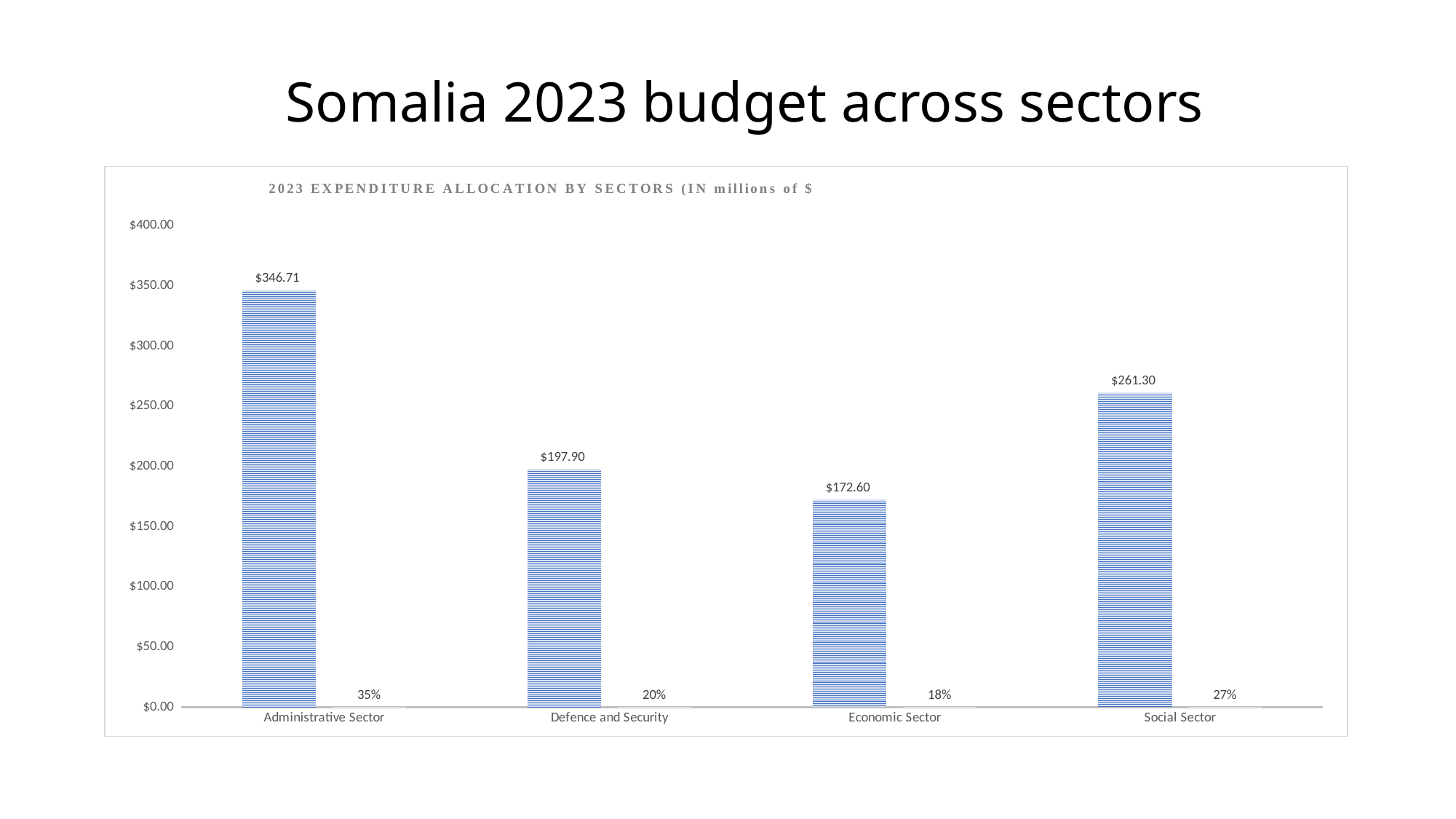
Which sector has the highest expenditure allocation? Administrative Sector Is the value for the Social Sector greater or less than $250.00? greater What is the 2023 expenditure allocation for Defence and Security? $197.90 What is the difference between the Administrative Sector and Social Sector allocations? $85.41 What is the title of the chart? 2023 EXPENDITURE ALLOCATION BY SECTORS (IN millions of $ Which has a larger allocation, Defence and Security or the Economic Sector? Defence and Security What kind of chart is shown on the slide? Bar chart What percentage share is shown for the Economic Sector? 18% What is the 2023 expenditure allocation for the Administrative Sector? $346.71 Which sector has the lowest expenditure allocation? Economic Sector How many sectors are shown in the chart? 4 What is the 2023 expenditure allocation for the Social Sector? $261.30